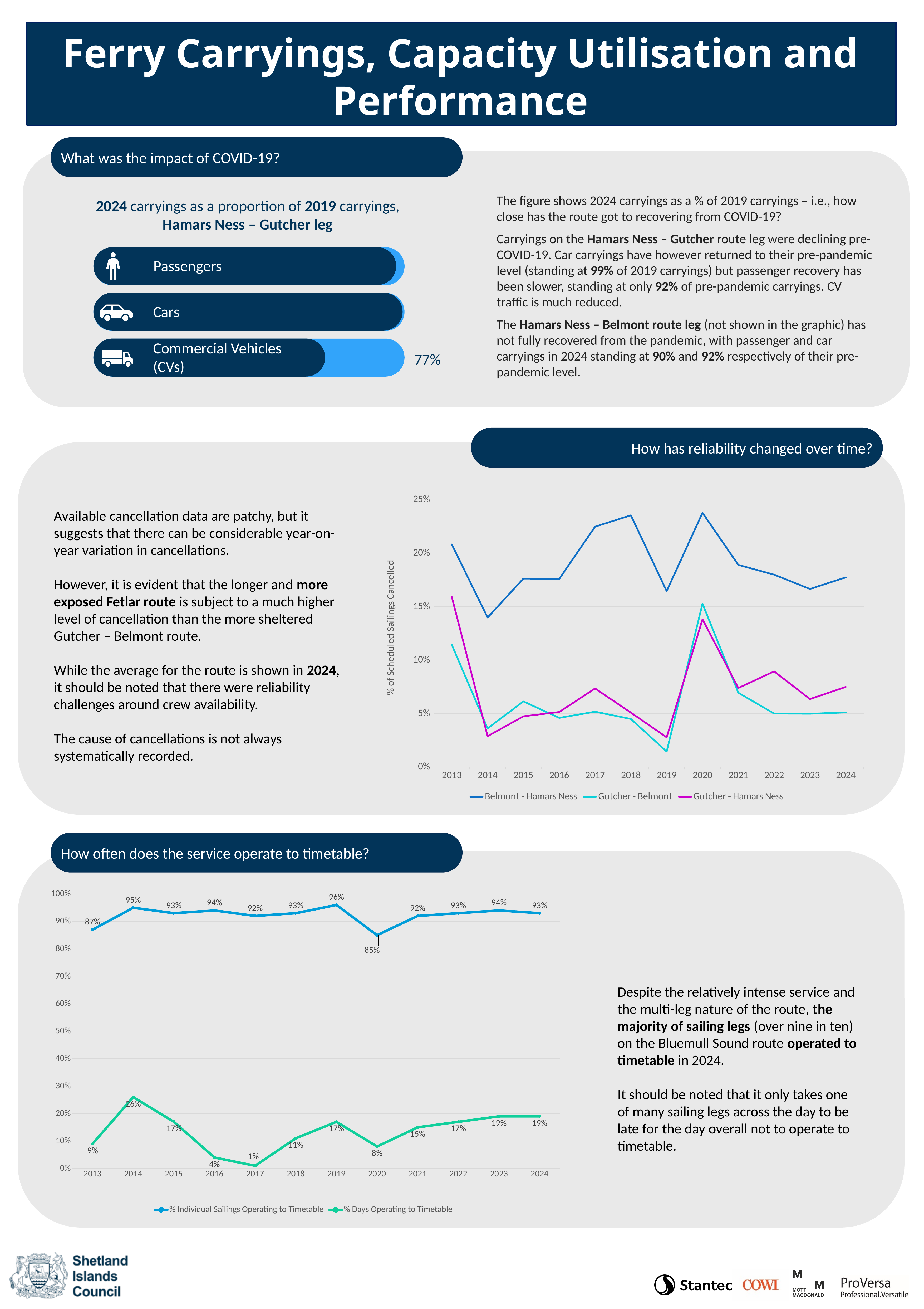
In the timetable chart at the bottom of the slide, what is the value of '% Individual Sailings Operating to Timetable' in 2020? 85% In the '% of Scheduled Sailings Cancelled' line chart, how many series does the legend list? 3 In the '2024 carryings as a proportion of 2019 carryings' bar chart, how many categories are shown? 3 In the timetable chart at the bottom of the slide, what is the difference between '% Individual Sailings Operating to Timetable' and '% Days Operating to Timetable' in 2024? 74 percentage points What kind of chart is the timetable chart at the bottom of the slide? Line chart In the timetable chart at the bottom of the slide, in which year is '% Individual Sailings Operating to Timetable' highest? 2019 In the '2024 carryings as a proportion of 2019 carryings' bar chart, what value is shown for Commercial Vehicles (CVs)? 77% In the '% of Scheduled Sailings Cancelled' line chart, is the value for Belmont - Hamars Ness in 2020 greater or less than 20%? greater In the timetable chart at the bottom of the slide, in which year is '% Days Operating to Timetable' lowest? 2017 In the '2024 carryings as a proportion of 2019 carryings' chart, which category has the lowest value? Commercial Vehicles (CVs) In the '% of Scheduled Sailings Cancelled' line chart, is the value for Belmont - Hamars Ness in 2014 greater or less than 15%? less In the '% of Scheduled Sailings Cancelled' line chart, which series has the highest cancellation rate across the years shown? Belmont - Hamars Ness